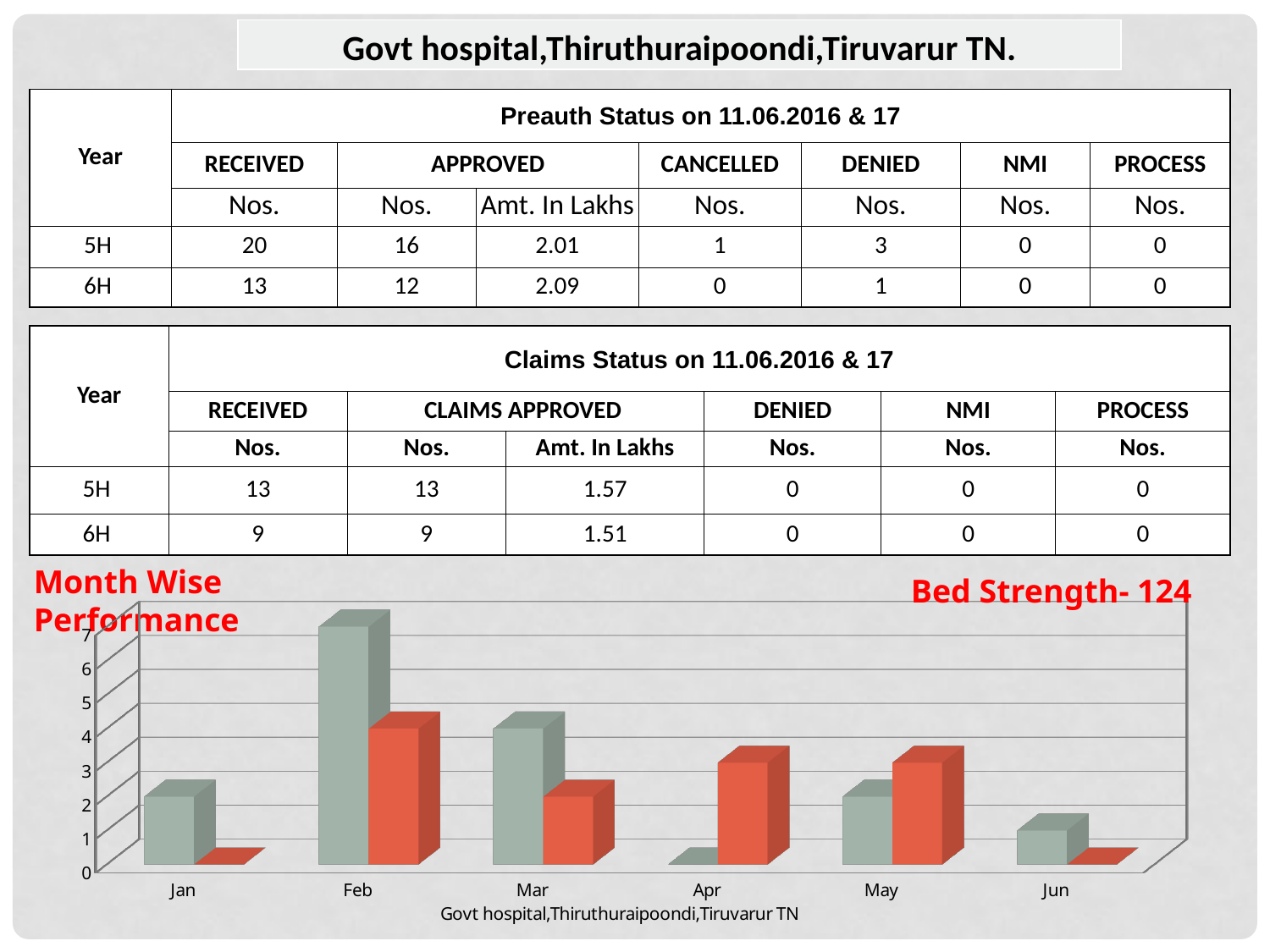
What kind of chart is the Month Wise Performance chart? bar chart In the Month Wise Performance chart, which month has the lowest grey bar? Apr In the Month Wise Performance chart, which month has the tallest red bar? Feb In the Month Wise Performance chart, is the grey bar for Jan greater or less than 3? less How many months are shown on the x axis of the Month Wise Performance chart? 6 What text appears below the x axis of the Month Wise Performance chart? Govt hospital,Thiruthuraipoondi,Tiruvarur TN In the Month Wise Performance chart, which is larger for Jun, the grey bar or the red bar? grey bar In the Month Wise Performance chart, is the grey bar for Feb greater or less than 6? greater In the Month Wise Performance chart, which month has the tallest grey bar? Feb In the Month Wise Performance chart, which is larger, the red bar for Apr or the red bar for Mar? Apr In the Month Wise Performance chart, is the grey bar for Mar greater or less than 5? less In the Month Wise Performance chart, which is larger, the grey bar for Feb or the grey bar for Mar? Feb